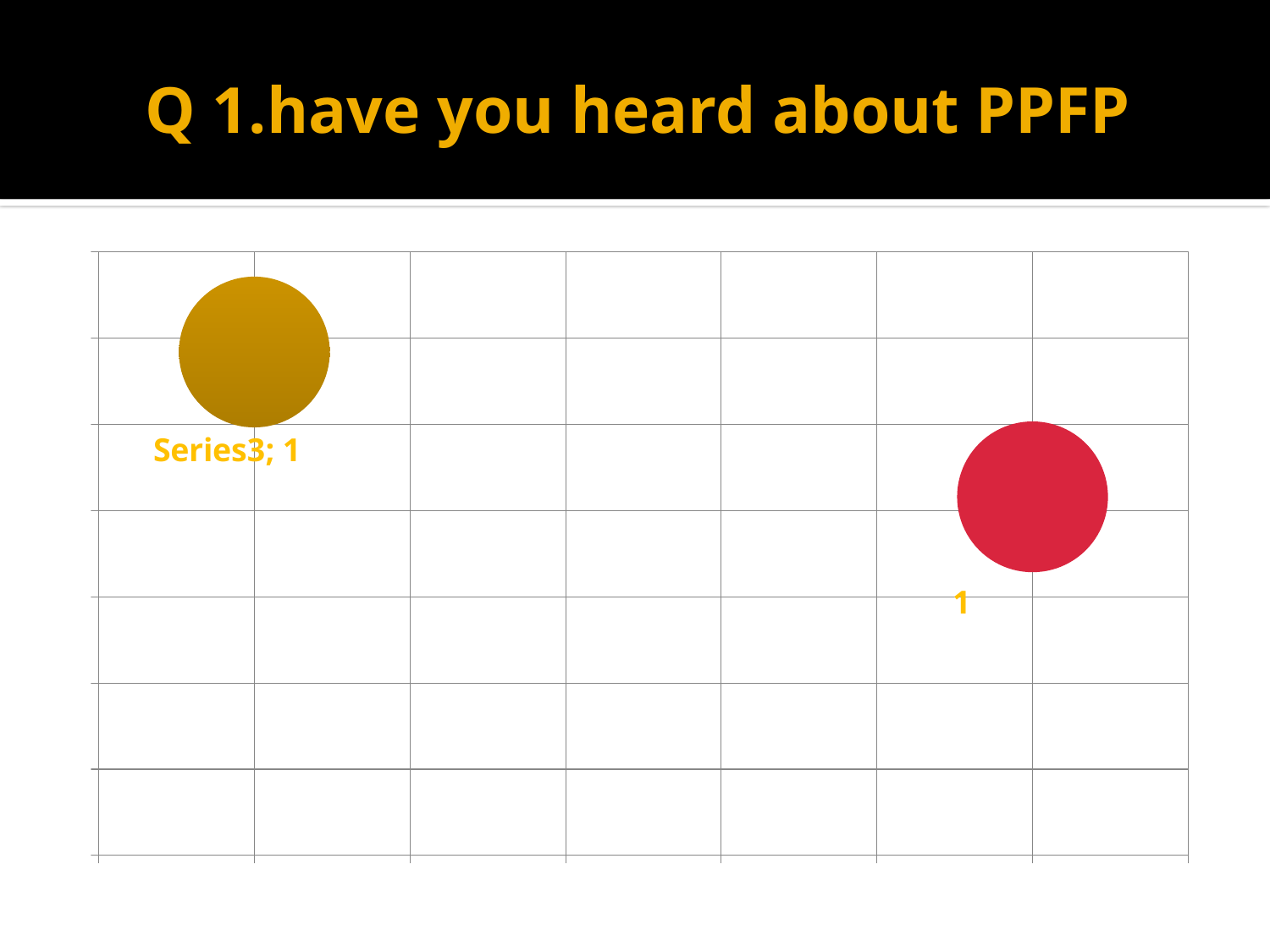
Which bubble is positioned further to the right on the chart, the gold one or the red one? the red one What kind of chart is shown on the slide? bubble chart Which bubble is positioned higher on the chart, the gold one or the red one? the gold one What is the title of the chart slide? Q 1.have you heard about PPFP What value is labelled for Series3? 1 What data label is shown next to the gold bubble? Series3; 1 What data label is shown next to the red bubble? 1 How many bubbles are plotted on the chart? 2 What colour is the bubble labelled Series3? gold